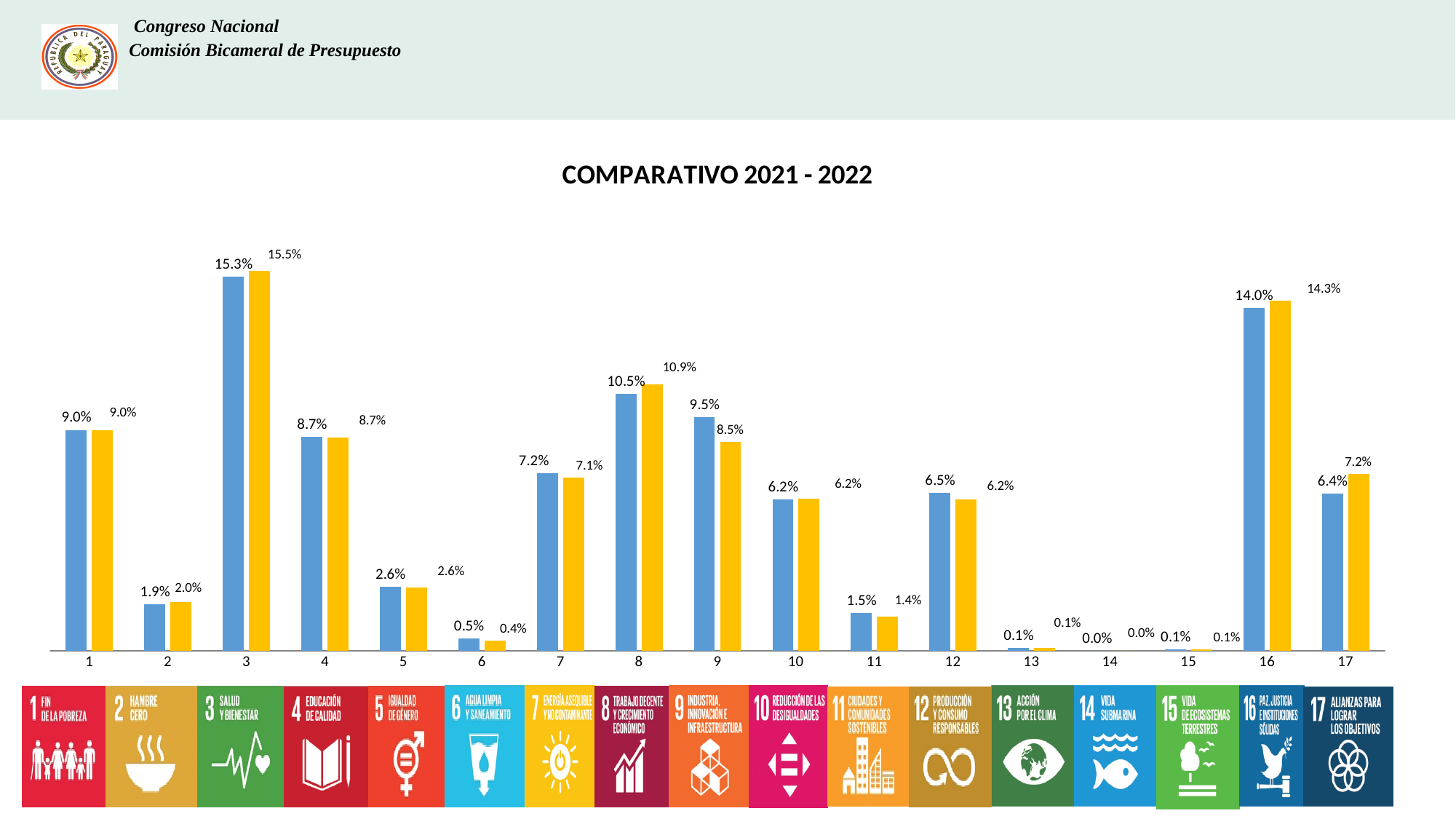
What is the value of the yellow bar for category 16? 14.3% For category 17, which bar is larger, the blue bar or the yellow bar? the yellow bar Which category has a higher blue bar, category 8 or category 9? 8 Which category has the lowest values, with both bars at 0.0%? 14 What is the value of the yellow bar for category 8? 10.9% Which category has the highest yellow bar? 3 What is the value of the blue bar for category 17? 6.4% What is the title of the chart? COMPARATIVO 2021 - 2022 What kind of chart is shown on the slide? bar chart How many categories are shown on the x axis of the chart? 17 What is the difference between the blue bar and the yellow bar for category 9? 1.0% What is the value of the blue bar for category 3? 15.3%